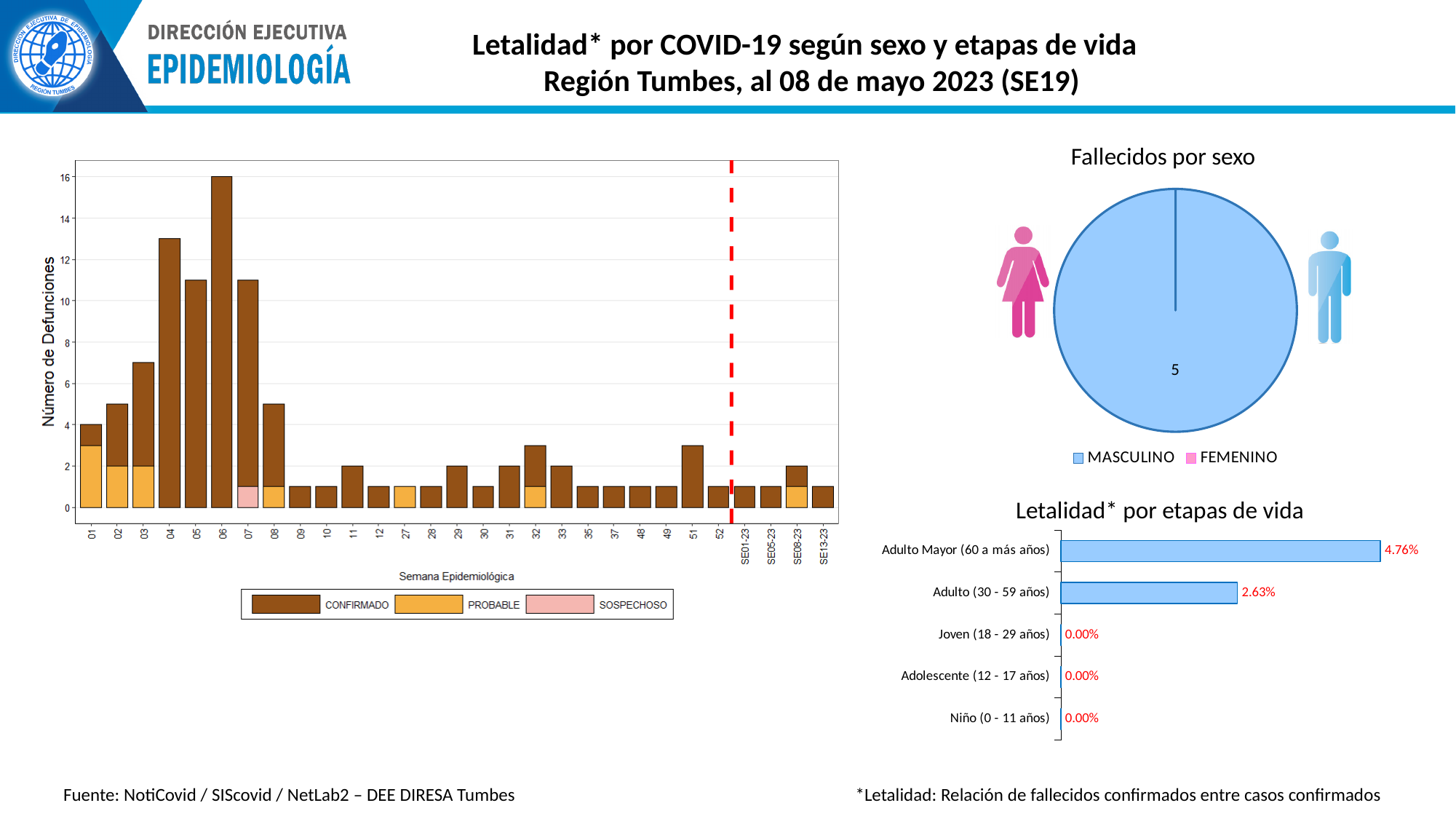
In the 'Letalidad* por etapas de vida' chart, what is the value for Adulto Mayor (60 a más años)? 4.76% In the 'Letalidad* por etapas de vida' chart, what is the value for Joven (18 - 29 años)? 0.00% In the 'Letalidad* por etapas de vida' chart, which age group has the highest lethality? Adulto Mayor (60 a más años) How many series does the legend of the bar chart on the left (Número de Defunciones by Semana Epidemiológica) list? 3 How many age groups are shown in the 'Letalidad* por etapas de vida' chart? 5 In the 'Letalidad* por etapas de vida' chart, what is the difference between the values for Adulto Mayor (60 a más años) and Adulto (30 - 59 años)? 2.13% In the bar chart on the left (Número de Defunciones by Semana Epidemiológica), which week has the highest number of deaths? 06 In the bar chart on the left (Número de Defunciones by Semana Epidemiológica), is the total for week 04 greater or less than 12? greater How many series does the legend of the 'Fallecidos por sexo' pie chart list? 2 In the 'Letalidad* por etapas de vida' chart, what is the value for Adulto (30 - 59 años)? 2.63% In the bar chart on the left (Número de Defunciones by Semana Epidemiológica), what is the total number of deaths in week 06? 16 In the 'Fallecidos por sexo' pie chart, what value is printed on the MASCULINO slice? 5